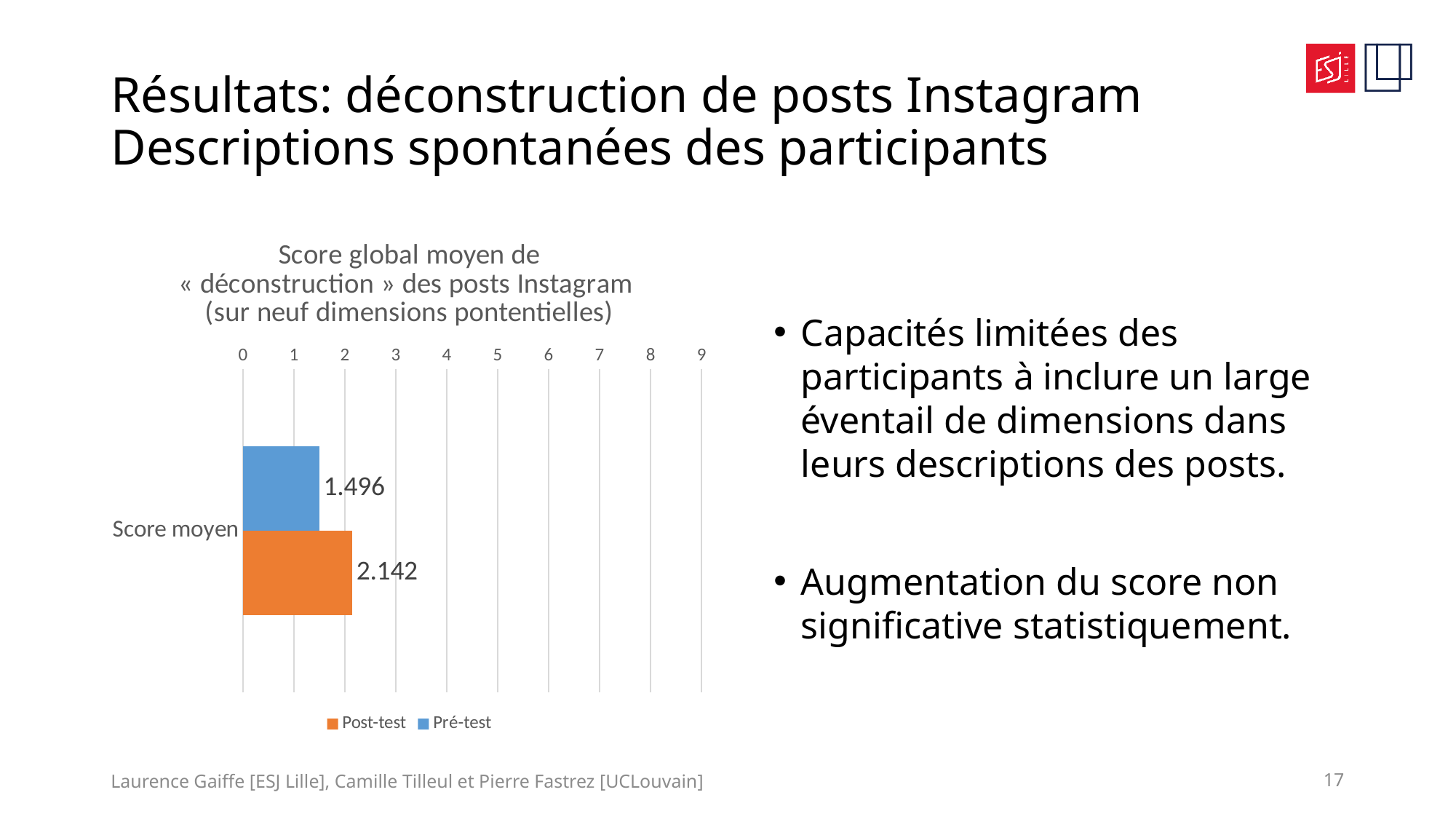
What is the maximum value shown on the chart's value axis? 9 What is the Pré-test value for Score moyen? 1.496 Is the Pré-test value for Score moyen greater or less than 2? less What is the Post-test value for Score moyen? 2.142 Which series has the higher value for Score moyen, Post-test or Pré-test? Post-test What is the difference between the Post-test and Pré-test values for Score moyen? 0.646 How many categories are shown on the chart? 1 How many series does the legend list? 2 What kind of chart is shown on the slide? bar chart Which colour represents the Post-test series? orange Is the Post-test value for Score moyen greater or less than 2? greater